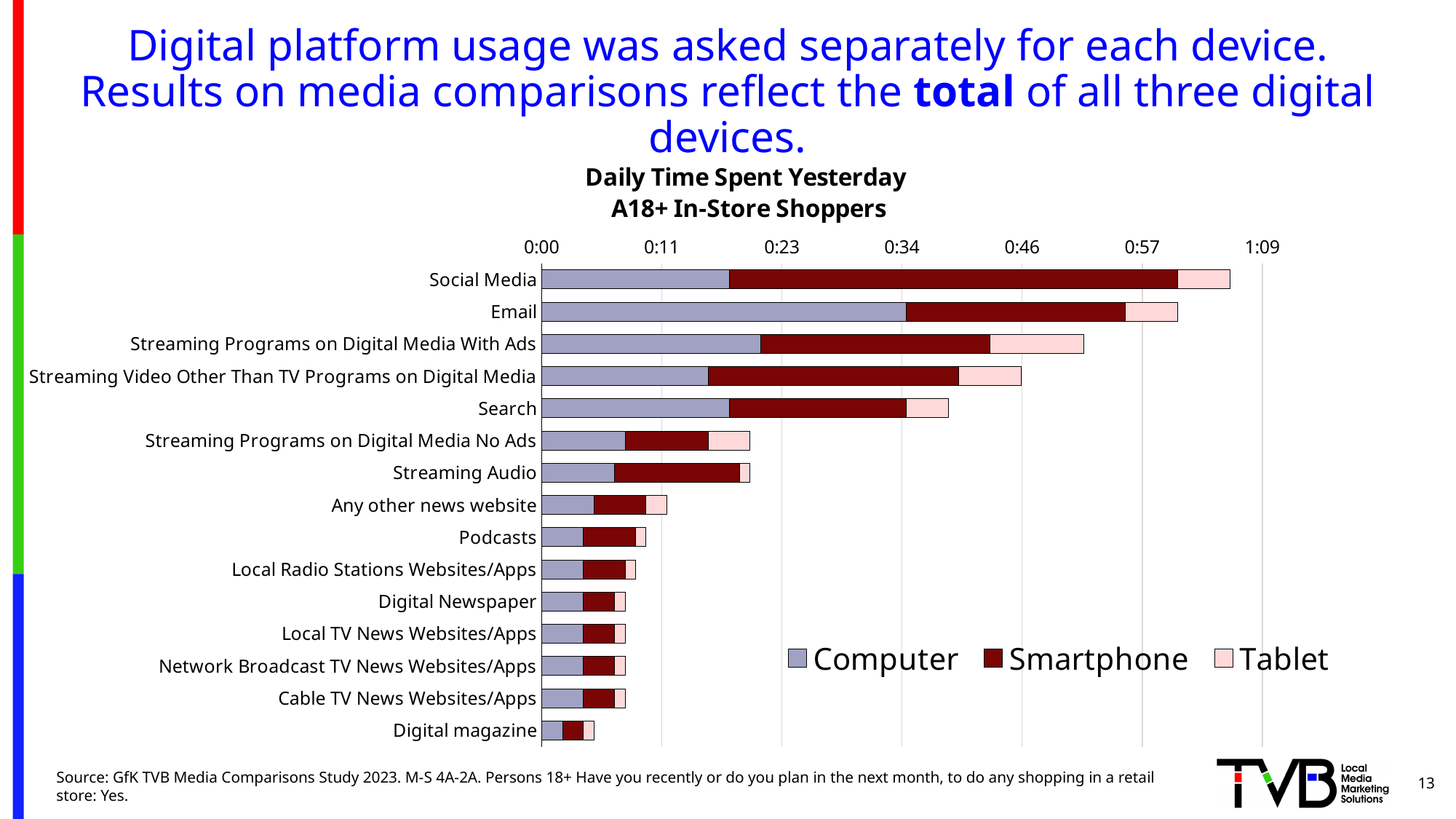
Which category has the longest total bar? Social Media Which category has the shortest total bar? Digital magazine How many series does the legend list? 3 Is the total daily time for Email greater or less than 1:09? less Is the total daily time for Streaming Audio greater or less than 0:23? less How many categories (media types) are plotted on the chart? 15 Is the total daily time for Search greater or less than 0:46? less Which category has the larger Computer segment, Email or Social Media? Email What kind of chart is shown on the slide? Stacked bar chart Which has a larger total bar, Social Media or Email? Social Media What is the title of the chart? Daily Time Spent Yesterday A18+ In-Store Shoppers